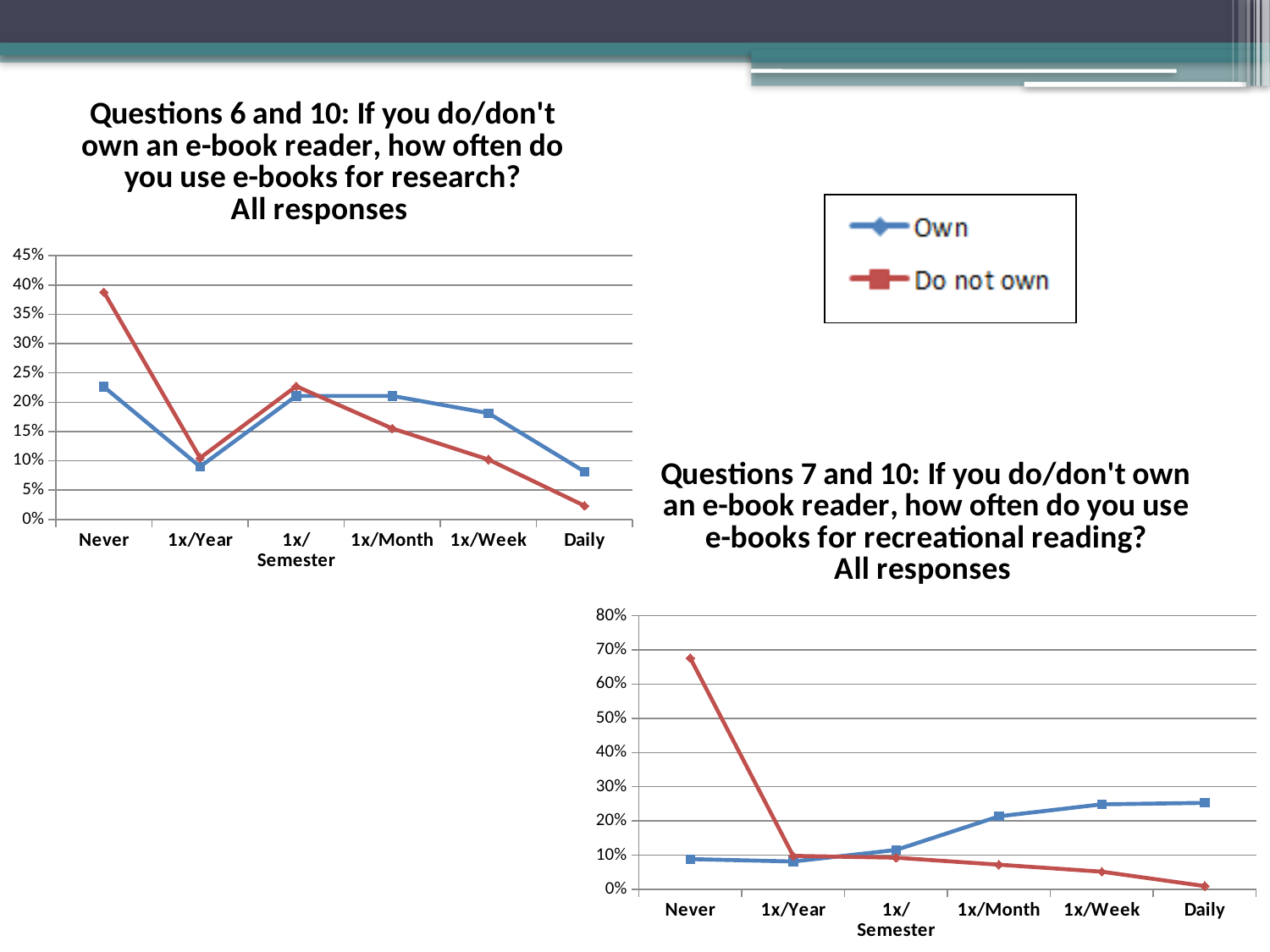
In the 'Questions 6 and 10' chart, which series has the larger value at Never, 'Own' or 'Do not own'? Do not own What colour is the 'Do not own' series in the legend? Red What kind of chart is used for 'Questions 6 and 10' on the left of the slide? Line chart How many series does the shared legend list? 2 In the 'Questions 7 and 10' chart, which series has the larger value at Daily, 'Own' or 'Do not own'? Own In the 'Questions 7 and 10' chart, at which category is the 'Do not own' series highest? Never In the 'Questions 7 and 10' chart, does the 'Own' series rise or fall from 1x/Semester to Daily? Rise In the 'Questions 7 and 10' chart, is the 'Do not own' value for Never greater or less than 60%? greater In the 'Questions 6 and 10' chart, at which category is the 'Do not own' series highest? Never In the 'Questions 6 and 10' chart, at which category is the 'Do not own' series lowest? Daily In the 'Questions 6 and 10' chart, how many frequency categories are shown on the x axis? 6 In the 'Questions 6 and 10' chart, is the 'Do not own' value for Never greater or less than 35%? greater